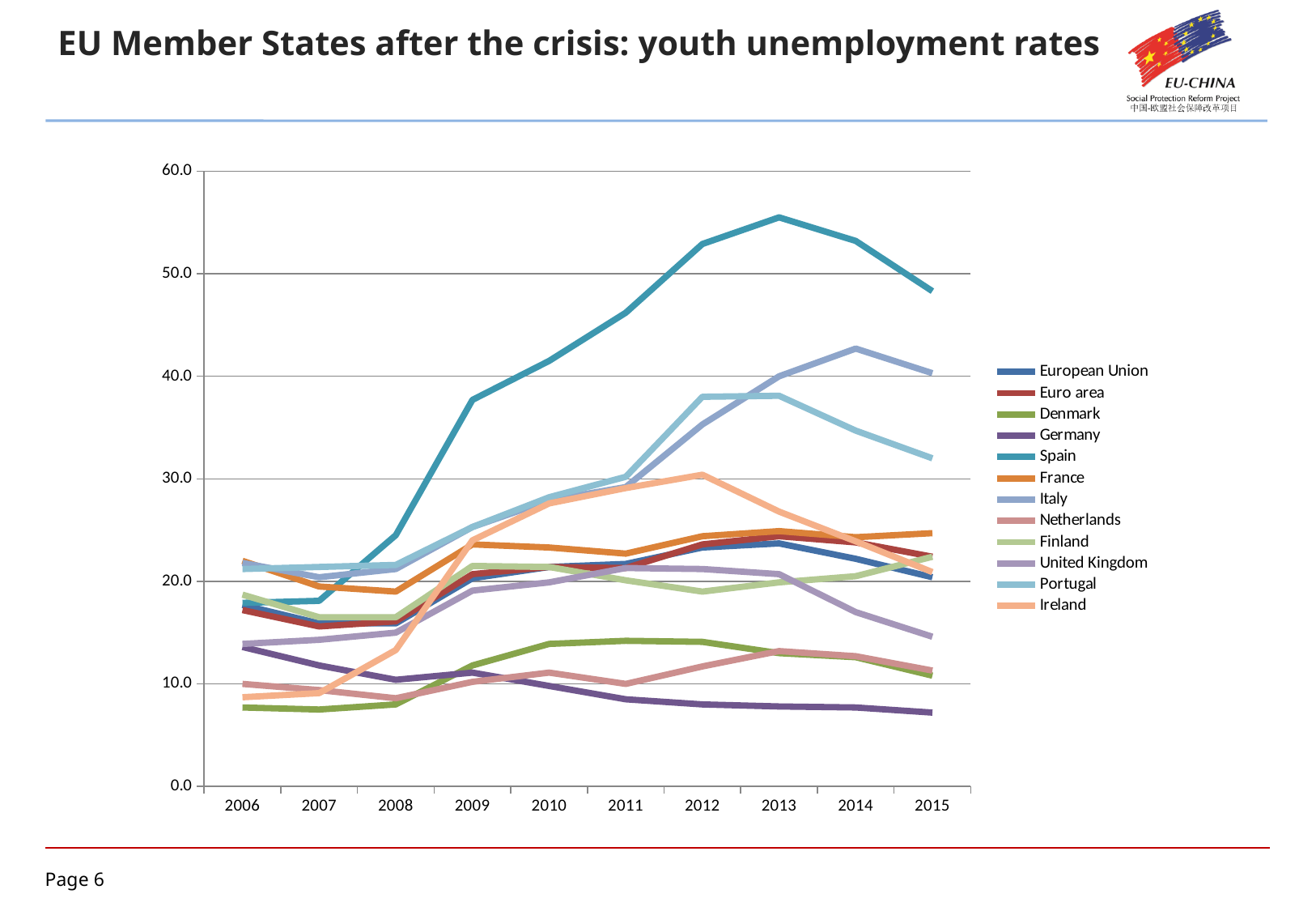
Is the value for Ireland in 2008 greater or less than 20.0? less Does the value for Germany rise or fall from 2006 to 2015? fall Which series has the lowest youth unemployment rate in 2015? Germany Is the value for Italy in 2014 greater or less than 40.0? greater How many years are shown on the x axis? 10 How many series does the legend list? 12 Which series has the highest youth unemployment rate in 2013? Spain Which is larger in 2012, the value for Portugal or the value for Ireland? Portugal Is the value for Germany in 2015 greater or less than 10.0? less What is the title of the slide? EU Member States after the crisis: youth unemployment rates What kind of chart is shown on the slide? line chart